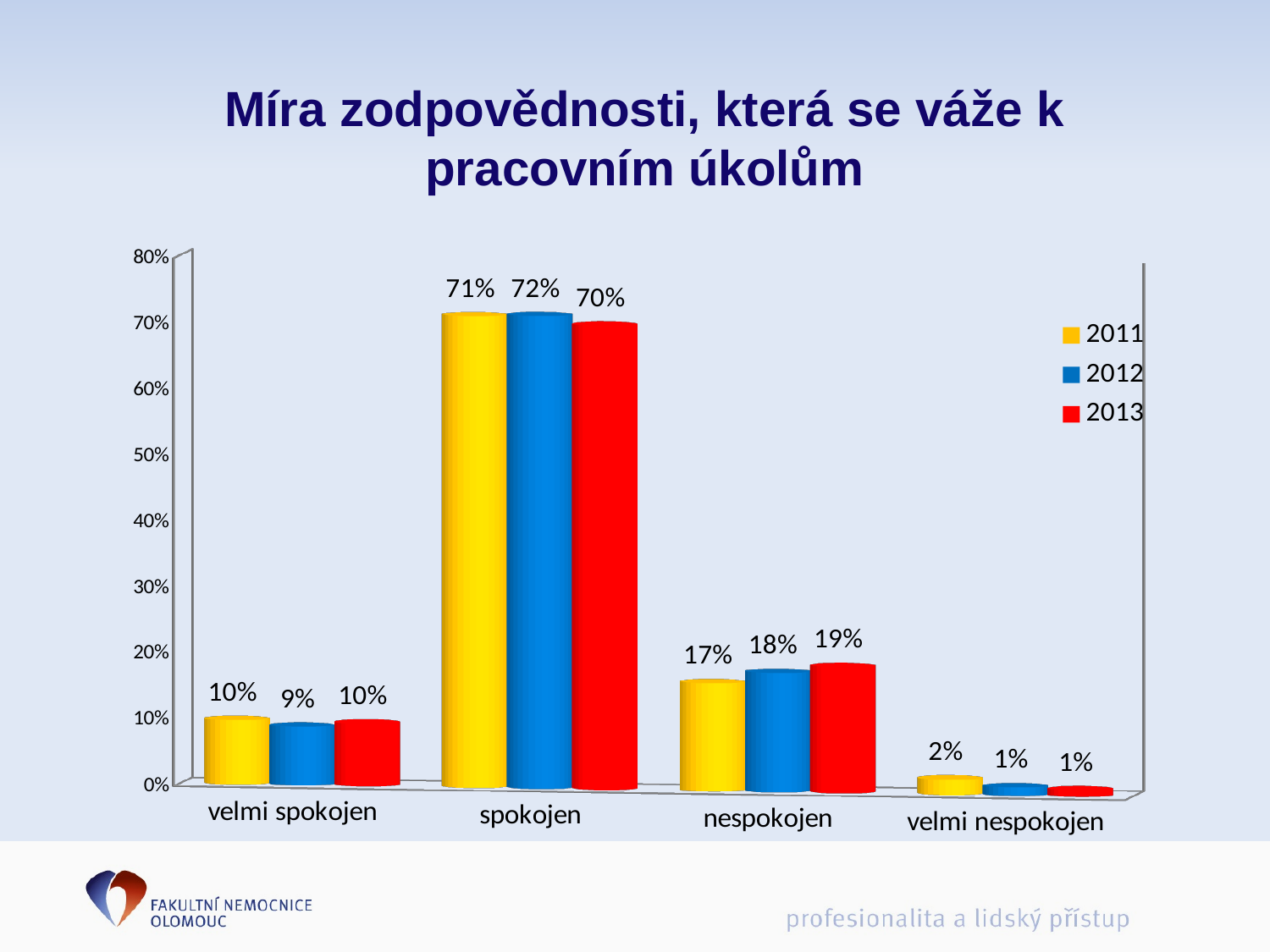
What is the value for 'velmi spokojen' in 2011? 10% Which category has the highest value in 2013? spokojen What is the value for 'velmi nespokojen' in 2011? 2% Which category has the lowest value in 2012? velmi nespokojen What is the value for 'spokojen' in 2012? 72% How many categories are shown on the x axis? 4 Which is larger: the 2011 value for 'spokojen' or the 2013 value for 'spokojen'? 2011 How many series does the legend list? 3 What kind of chart is shown on the slide? bar chart What is the difference between the 2011 and 2013 values for 'nespokojen'? 2% What is the value for 'nespokojen' in 2013? 19% Which colour represents the 2012 series? blue